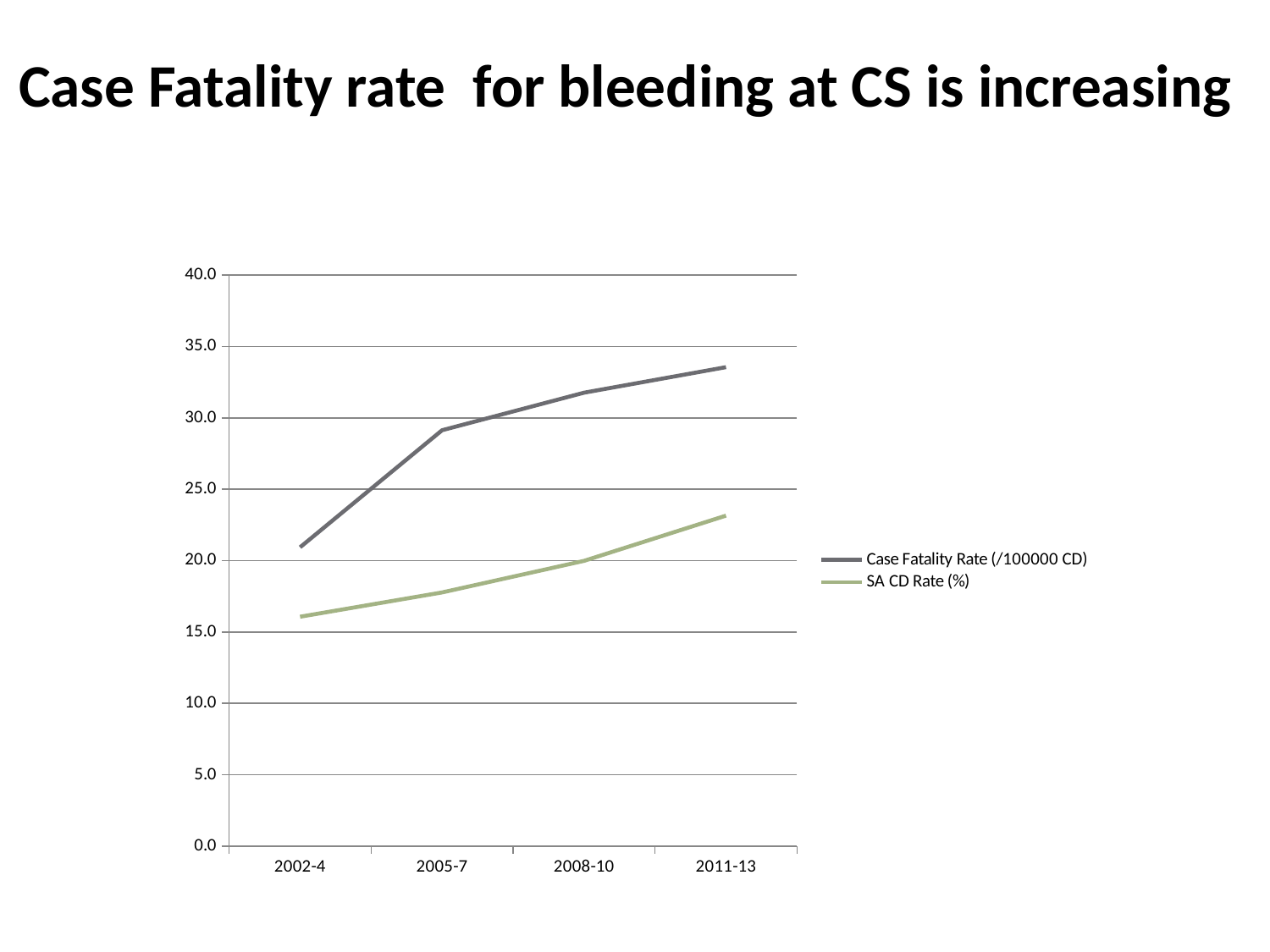
Is the SA CD Rate (%) for 2005-7 greater or less than 20.0? less Does the Case Fatality Rate (/100000 CD) rise or fall from 2002-4 to 2011-13? rise In which period is the SA CD Rate (%) lowest? 2002-4 Does the SA CD Rate (%) rise or fall across the periods shown? rise What is the title of the slide? Case Fatality rate for bleeding at CS is increasing What kind of chart is shown on the slide? line chart Is the Case Fatality Rate (/100000 CD) for 2002-4 greater or less than 25.0? less Which series has the larger value in 2008-10, Case Fatality Rate (/100000 CD) or SA CD Rate (%)? Case Fatality Rate (/100000 CD) How many time periods are shown on the x axis? 4 In which period is the Case Fatality Rate (/100000 CD) highest? 2011-13 Is the Case Fatality Rate (/100000 CD) for 2011-13 greater or less than 30.0? greater How many series does the legend list? 2